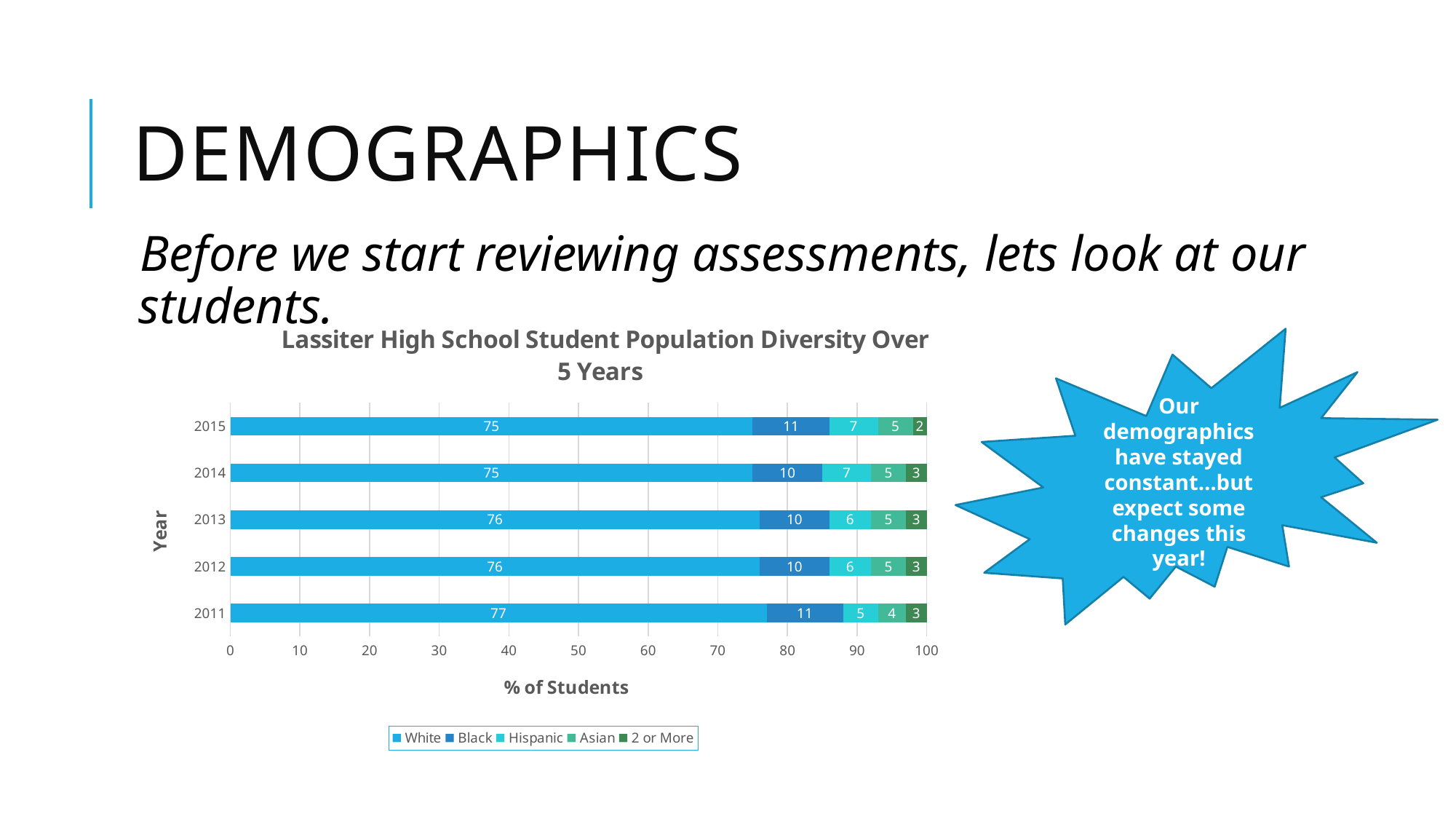
What is the difference between the White value for 2011 and the White value for 2015? 2 How many years are shown on the chart? 5 How many series does the legend list? 5 What is the 2 or More value for 2015? 2 Which year has the highest White value? 2011 What kind of chart is shown? Stacked bar chart What is the Black value for 2011? 11 What is the White value for 2015? 75 What is the total of the stacked bar for 2014? 100 What is the Hispanic value for 2013? 6 Which is larger, the Hispanic value for 2014 or the Hispanic value for 2011? 2014 Which year has the lowest Hispanic value? 2011